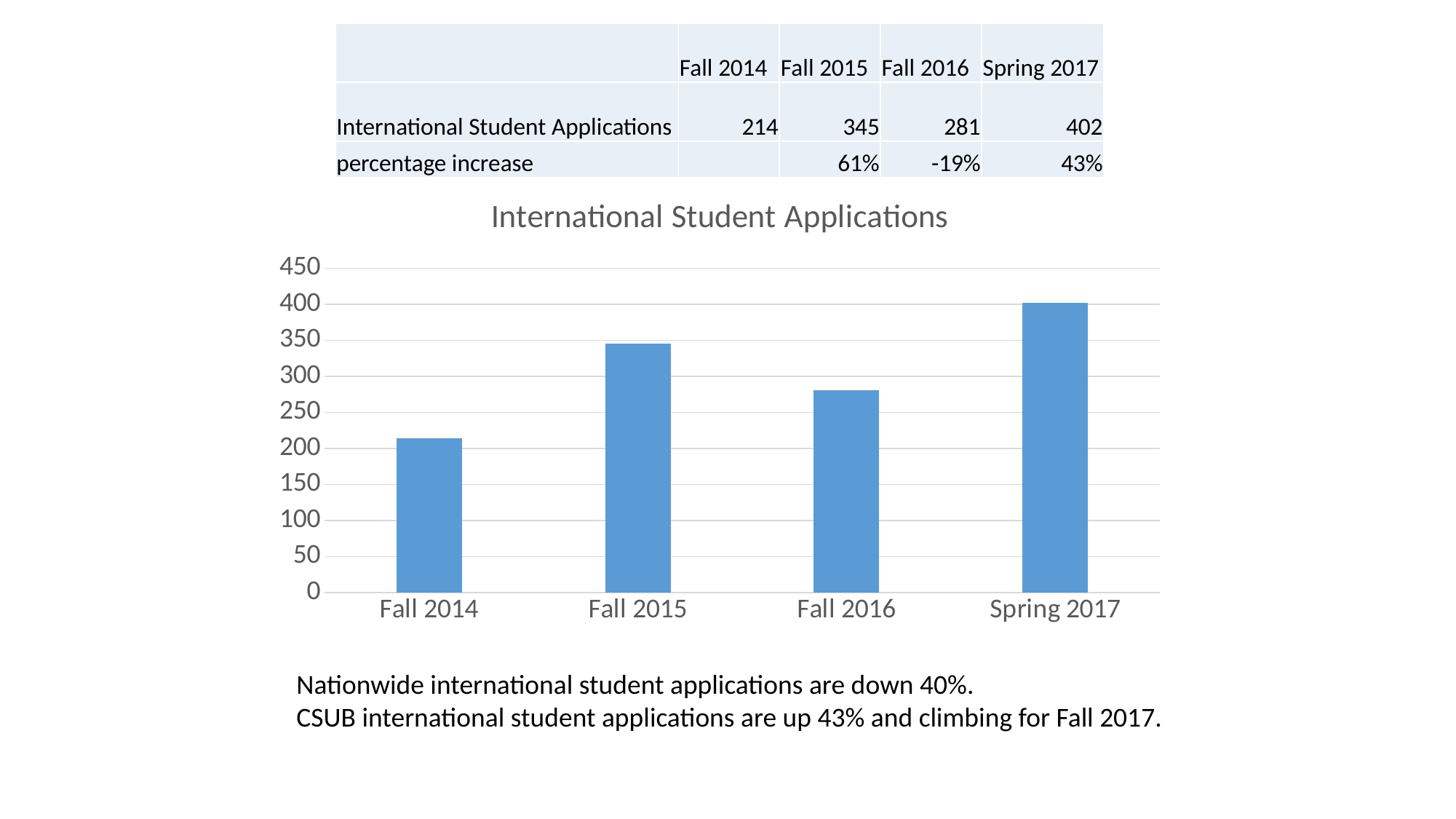
What is the difference between the values for Spring 2017 and Fall 2014? 188 What is the value for Fall 2016? 281 Which category has the lowest value? Fall 2014 What is the difference between the values for Fall 2015 and Fall 2016? 64 How many categories are shown on the x axis of the chart? 4 What type of chart is shown on the slide? bar chart What is the value for Fall 2014? 214 Is the value for Fall 2016 greater or less than 300? less Which category has the highest value? Spring 2017 What is the title of the chart? International Student Applications Which is larger, the value for Fall 2015 or the value for Fall 2016? Fall 2015 What is the value for Spring 2017? 402